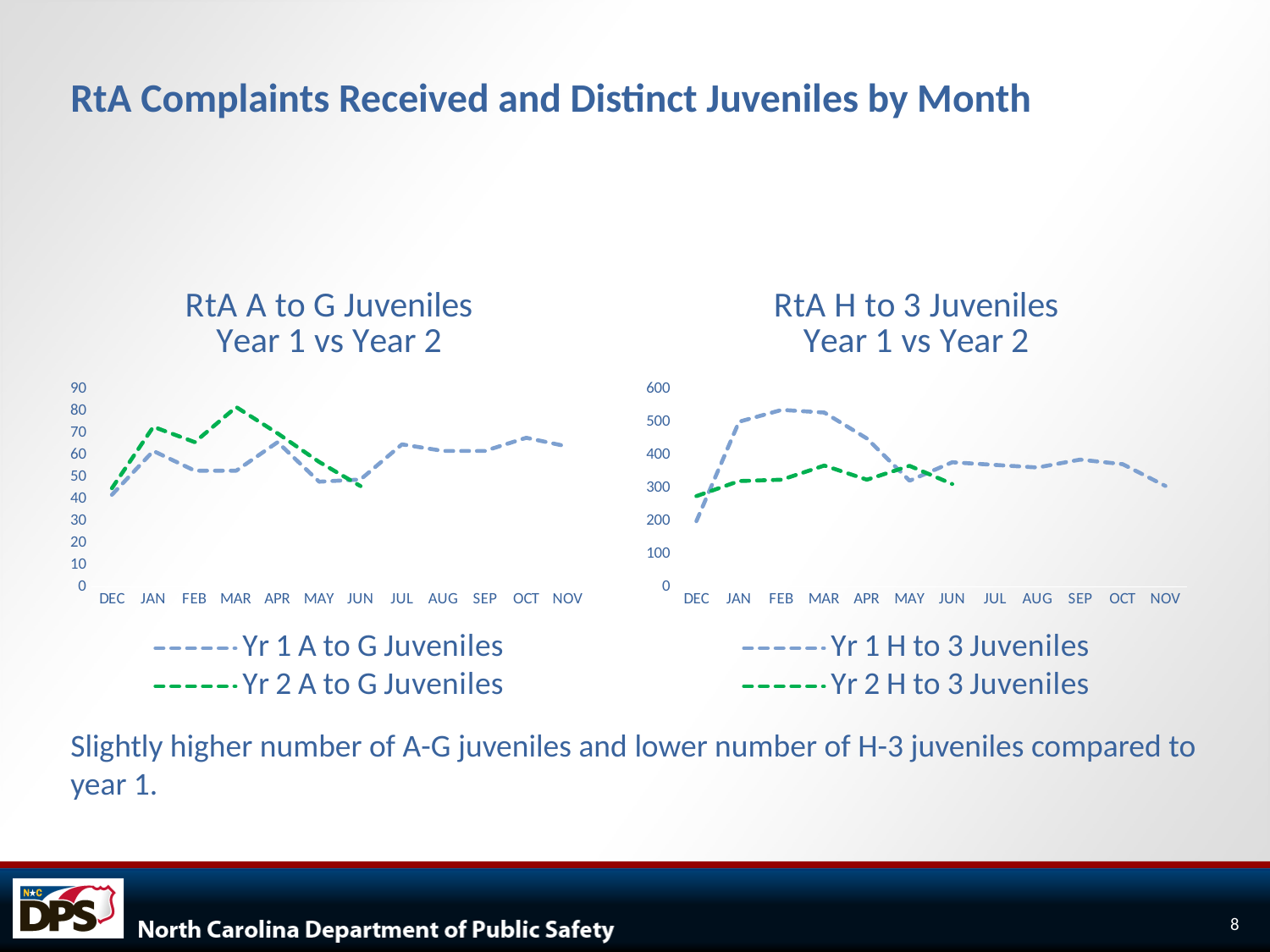
In the 'RtA H to 3 Juveniles Year 1 vs Year 2' chart, is the Yr 1 H to 3 Juveniles value for DEC greater or less than 300? less In the 'RtA H to 3 Juveniles Year 1 vs Year 2' chart, does the Yr 1 H to 3 Juveniles line rise or fall from FEB to MAY? fall In the 'RtA A to G Juveniles Year 1 vs Year 2' chart, in which month is the Yr 1 A to G Juveniles line at its lowest? DEC How many series does the legend of the 'RtA H to 3 Juveniles Year 1 vs Year 2' chart list? 2 In the 'RtA H to 3 Juveniles Year 1 vs Year 2' chart, is the Yr 1 H to 3 Juveniles value for FEB greater or less than 500? greater In the 'RtA A to G Juveniles Year 1 vs Year 2' chart, is the Yr 2 A to G Juveniles value for MAR greater or less than 70? greater In the 'RtA A to G Juveniles Year 1 vs Year 2' chart, what colour is the Yr 2 A to G Juveniles line? green How many months are shown on the x axis of the 'RtA A to G Juveniles Year 1 vs Year 2' chart? 12 In the 'RtA H to 3 Juveniles Year 1 vs Year 2' chart, in which month is the Yr 1 H to 3 Juveniles line at its lowest? DEC In the 'RtA H to 3 Juveniles Year 1 vs Year 2' chart, which series has the higher value in FEB, Yr 1 H to 3 Juveniles or Yr 2 H to 3 Juveniles? Yr 1 H to 3 Juveniles In the 'RtA A to G Juveniles Year 1 vs Year 2' chart, in which month does the Yr 2 A to G Juveniles line reach its highest value? MAR What kind of chart is the 'RtA A to G Juveniles Year 1 vs Year 2' chart? line chart